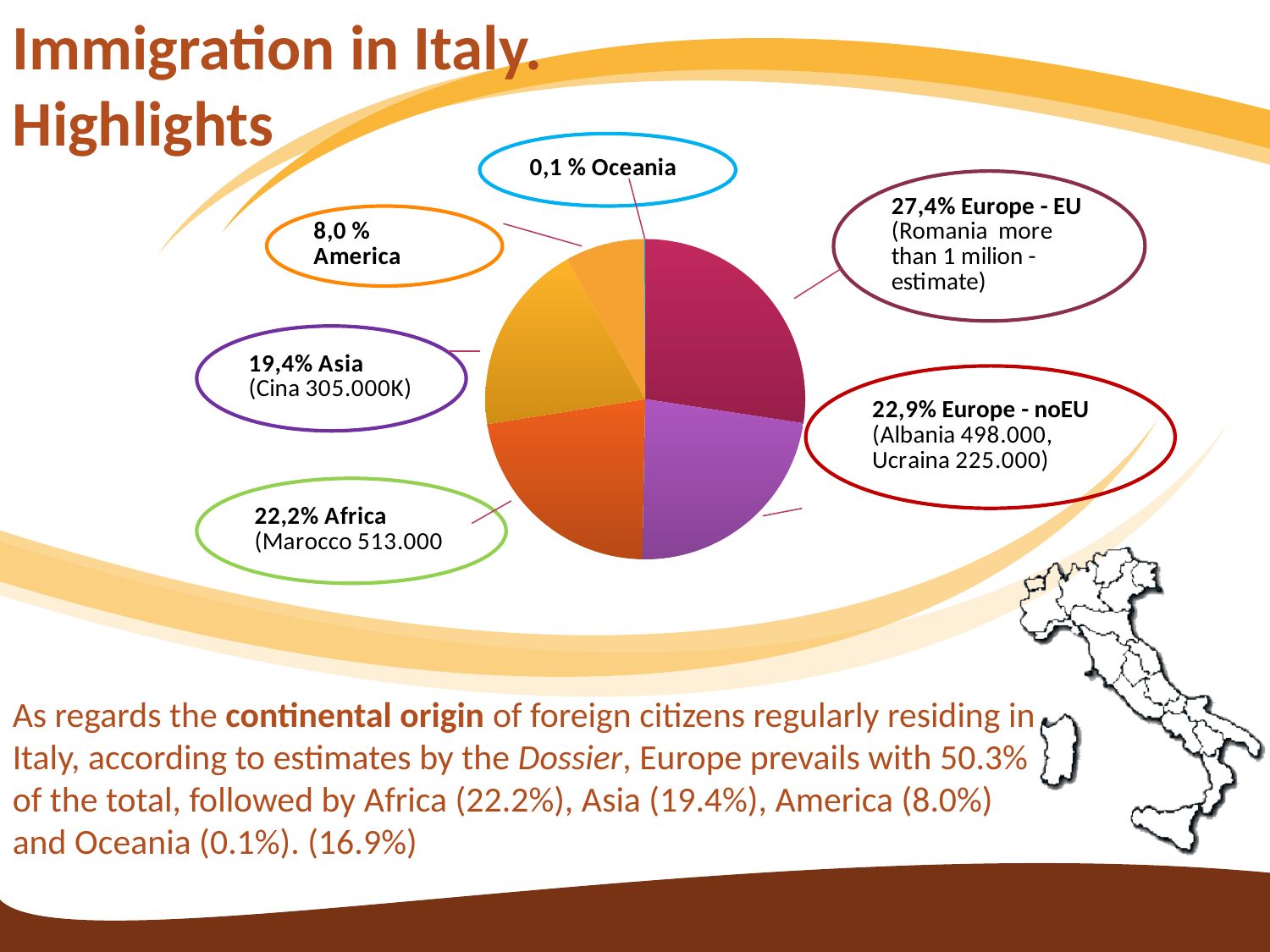
What share of the pie chart is Europe - noEU? 22,9% How many slices does the pie chart have? 6 What kind of chart is shown on the slide? pie chart What share of the pie chart is Africa? 22,2% What is the difference in percentage points between the Europe - EU slice and the Europe - noEU slice? 4,5 Which continent has the smallest slice of the pie chart? Oceania What share of the pie chart is America? 8,0 % Which slice is larger in the pie chart, Africa or Asia? Africa Which continent has the largest slice of the pie chart? Europe - EU What share of the pie chart is Asia? 19,4% What share of the pie chart is Europe - EU? 27,4% What is the combined share of the Europe - EU and Europe - noEU slices? 50,3%